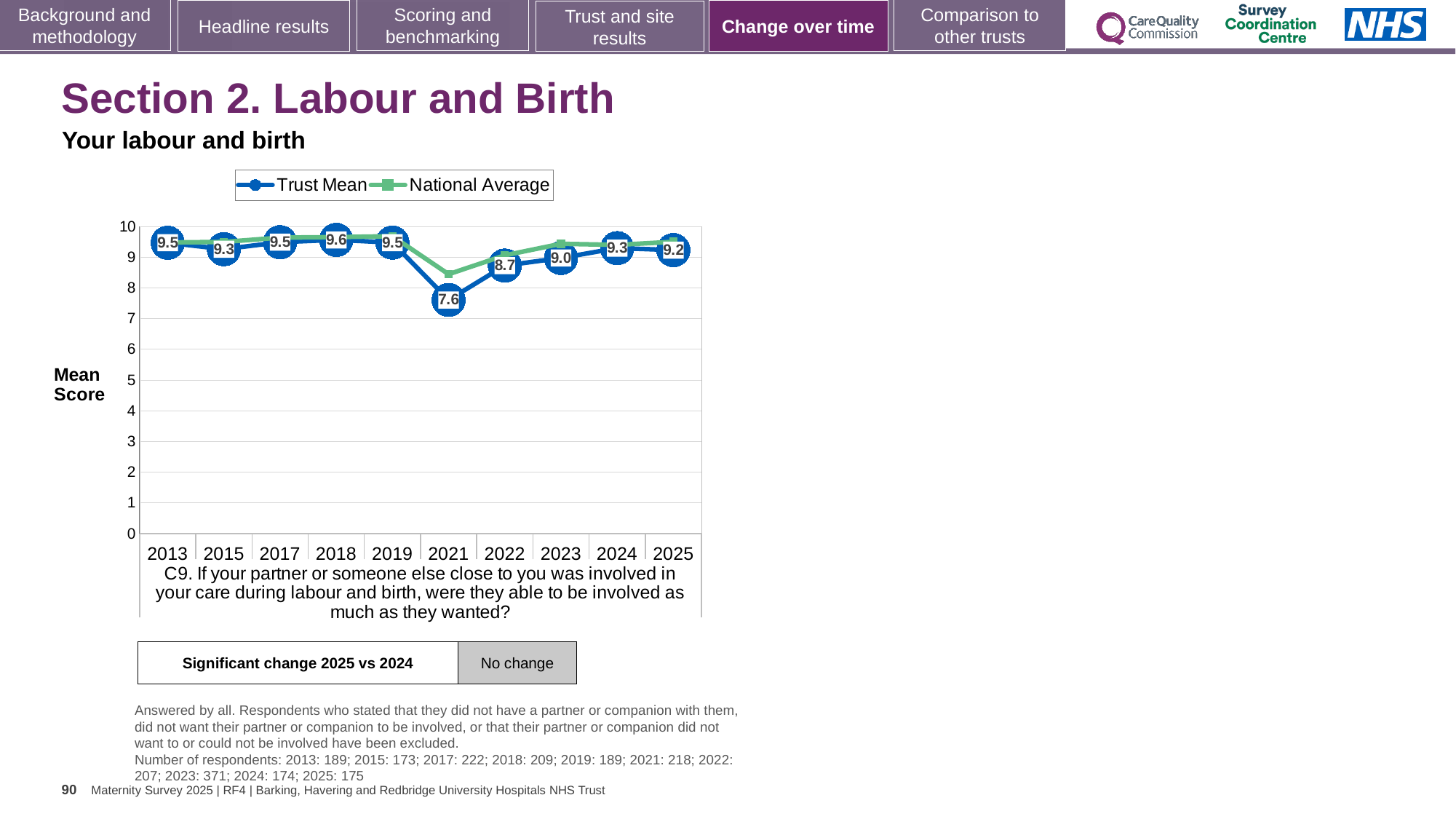
How many series does the chart legend list? 2 What is the difference between the Trust Mean scores for 2018 and 2021? 2.0 In which year is the Trust Mean score lowest? 2021 Does the Trust Mean score rise or fall from 2021 to 2024? Rise What is the Trust Mean score for 2021? 7.6 What kind of chart is shown on the slide? Line chart In which year is the Trust Mean score highest? 2018 How many years are shown on the x axis of the chart? 10 Which year has the larger Trust Mean score, 2022 or 2024? 2024 What is the Trust Mean score for 2018? 9.6 Is the National Average value for 2021 greater or less than 8? greater What is the Trust Mean score for 2025? 9.2